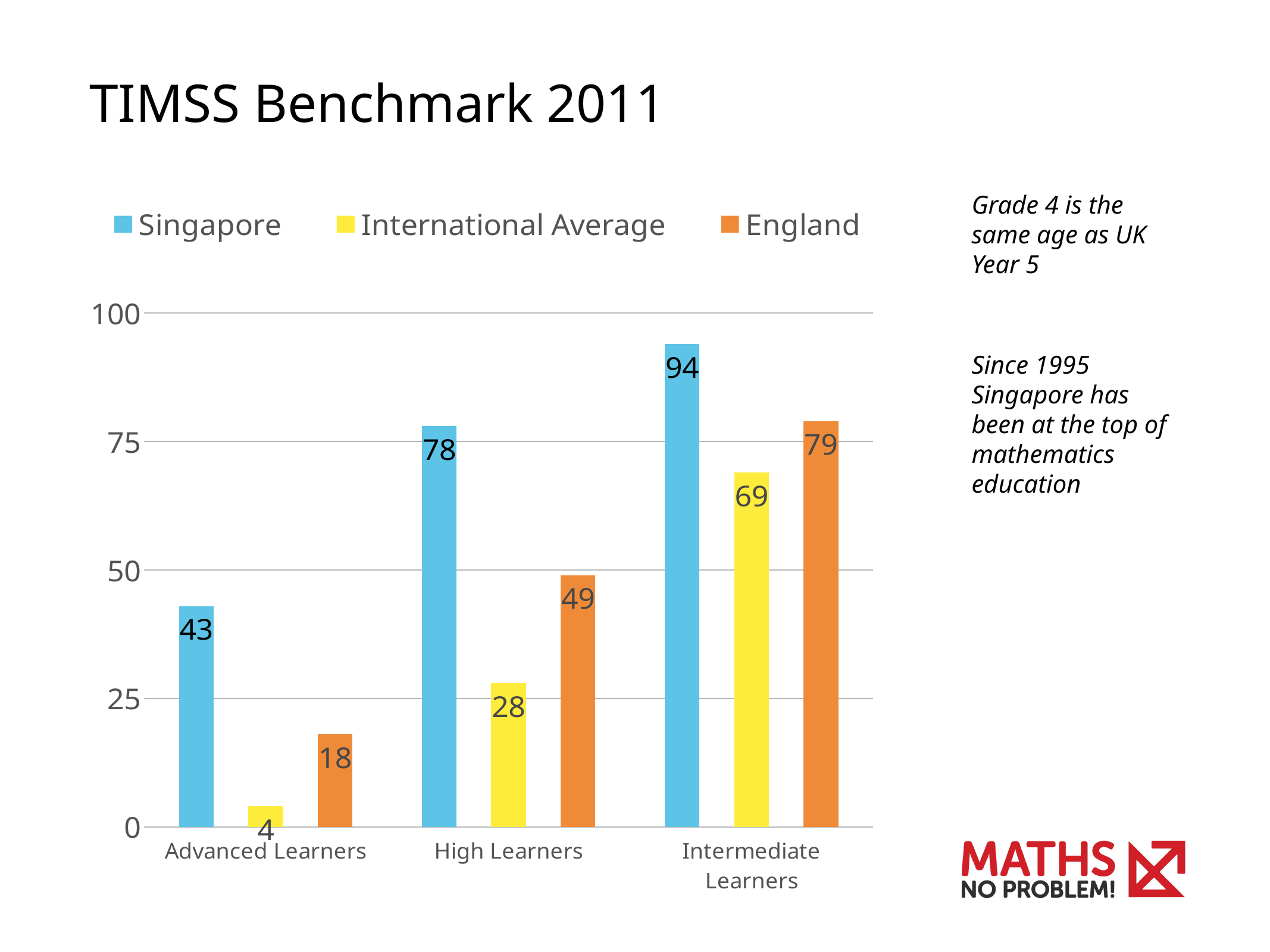
Which category has the highest value for Singapore? Intermediate Learners What is the value for England in the High Learners category? 49 Which series is shown in yellow in the legend? International Average Which category has the lowest value for International Average? Advanced Learners What is the difference between the Singapore and England values for High Learners? 29 Which is larger in the Intermediate Learners category: the value for England or the value for International Average? England Is the value for England in the Advanced Learners category greater or less than 25? less How many series does the legend list? 3 What is the value for Singapore in the Advanced Learners category? 43 What kind of chart is shown on the slide? bar chart How many categories are shown on the x axis? 3 What is the value for International Average in the Intermediate Learners category? 69